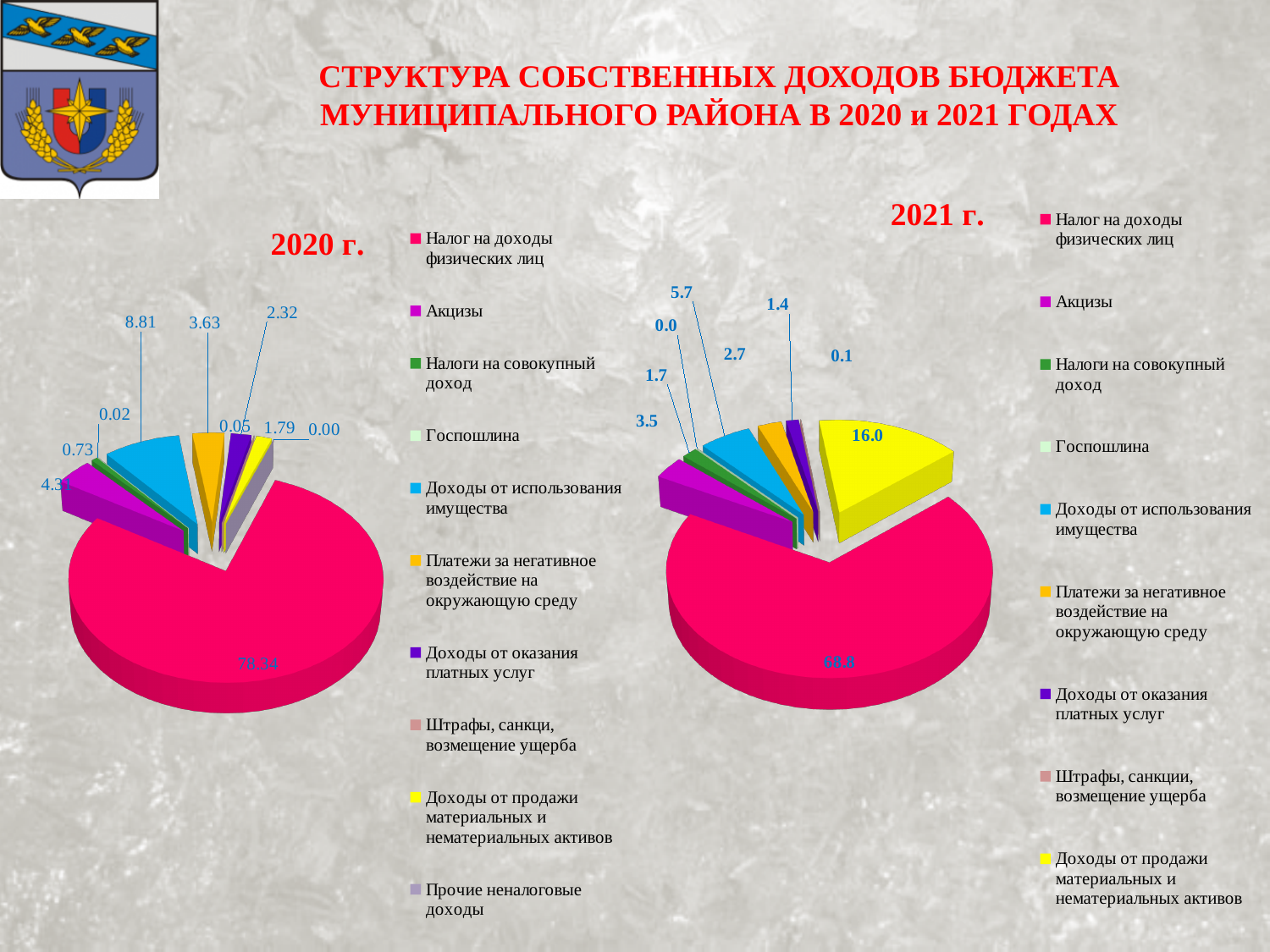
How many categories does the legend of the 2020 г. chart list? 10 In the 2021 г. chart, what is the value for Доходы от использования имущества? 5.7 In the 2020 г. chart, what is the value for Доходы от использования имущества? 8.81 What kind of charts are shown on the slide? Pie charts In the 2021 г. chart, what is the value of the largest slice (Налог на доходы физических лиц)? 68.8 In the 2021 г. chart, what is the value for Доходы от продажи материальных и нематериальных активов? 16.0 By how much does the Налог на доходы физических лиц share in the 2020 г. chart exceed that in the 2021 г. chart? 9.54 In the 2020 г. chart, which category has the largest slice? Налог на доходы физических лиц Which chart shows a larger value for Акцизы, 2020 г. or 2021 г.? 2020 г. In the 2021 г. chart, what is the value for Акцизы? 3.5 In the 2020 г. chart, what is the value of the largest slice (Налог на доходы физических лиц)? 78.34 In the 2020 г. chart, what is the value for Акцизы? 4.31